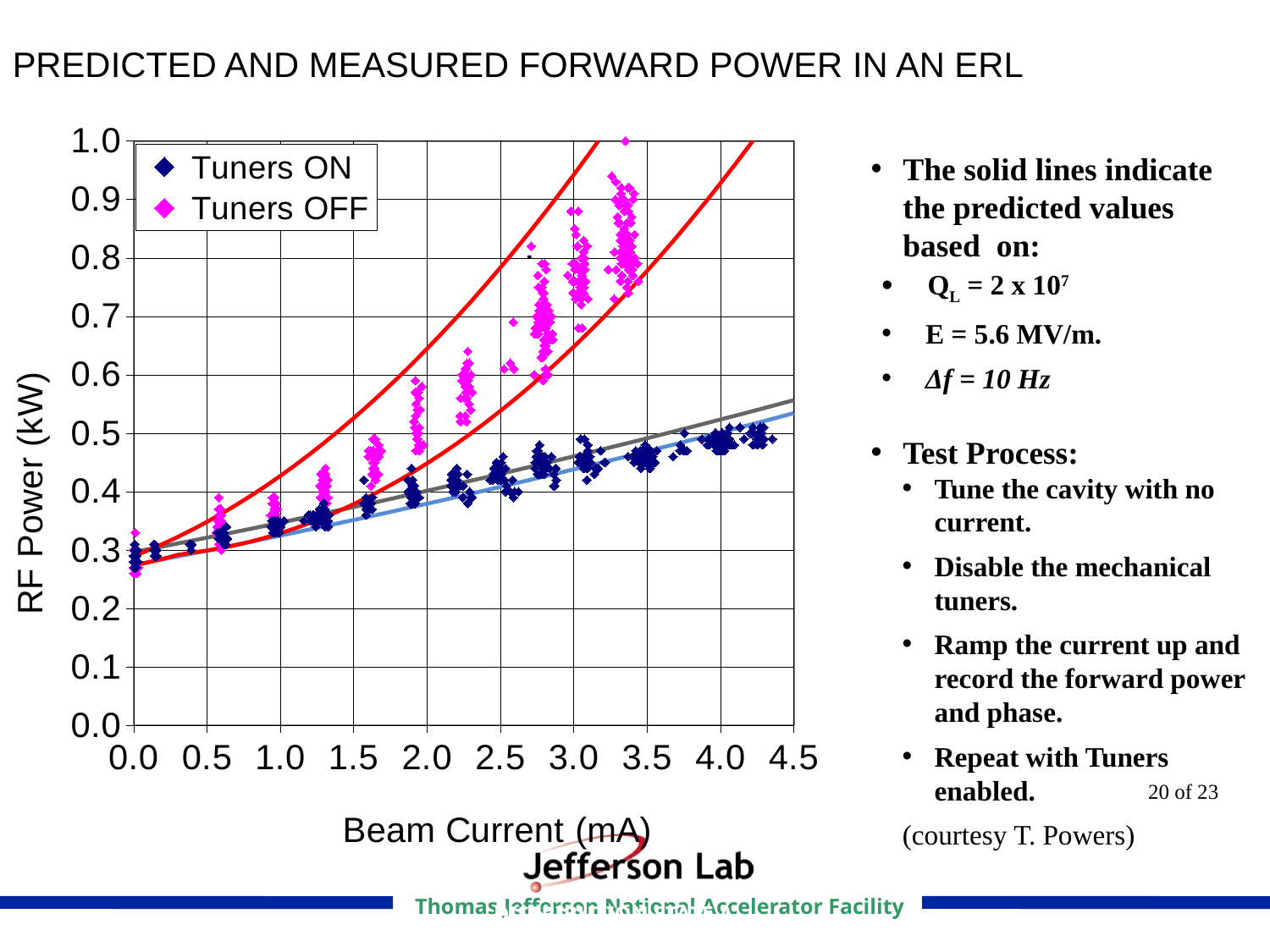
Is the RF Power for Tuners OFF at a beam current of 3.0 mA greater or less than 0.6 kW? greater What are the two series named in the chart legend? Tuners ON and Tuners OFF What kind of chart is shown on the slide? Scatter chart Is the RF Power for Tuners ON at a beam current of 4.0 mA greater or less than 0.4 kW? greater Which series reaches the higher RF Power values on the chart, Tuners ON or Tuners OFF? Tuners OFF Does the RF Power for the Tuners OFF series rise or fall as beam current increases? Rises At a beam current of about 3.0 mA, which series shows the larger RF Power, Tuners ON or Tuners OFF? Tuners OFF What is the label of the x axis of the chart? Beam Current (mA) How many series does the chart legend list? 2 Is the RF Power for Tuners OFF at a beam current of 2.0 mA greater or less than 0.4 kW? greater Does the RF Power for the Tuners ON series rise or fall as beam current increases? Rises